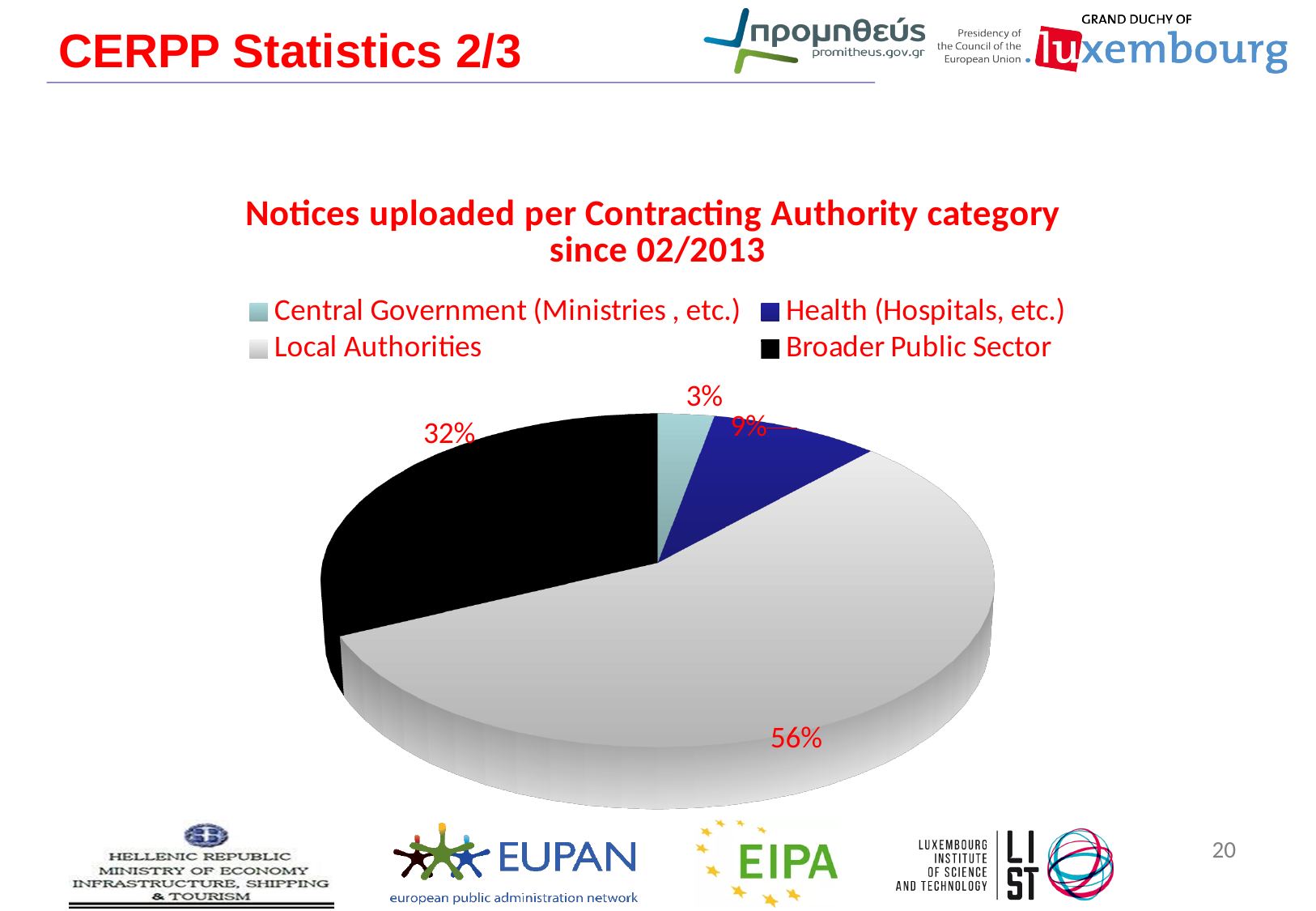
Which has a larger share of notices uploaded, Health (Hospitals, etc.) or Central Government (Ministries, etc.)? Health (Hospitals, etc.) How many contracting authority categories are shown in the pie chart? 4 What is the title of the chart? Notices uploaded per Contracting Authority category since 02/2013 What share of notices uploaded comes from the Broader Public Sector? 32% What share of notices uploaded comes from Health (Hospitals, etc.)? 9% What share of notices uploaded comes from Local Authorities? 56% Which contracting authority category has the smallest share of notices uploaded? Central Government (Ministries , etc.) Which colour represents the Broader Public Sector in the pie chart? Black What is the difference in percentage points between the Local Authorities share and the Broader Public Sector share? 24 What type of chart is used to show notices uploaded per contracting authority category? Pie chart Which contracting authority category has the largest share of notices uploaded? Local Authorities What share of notices uploaded comes from Central Government (Ministries, etc.)? 3%